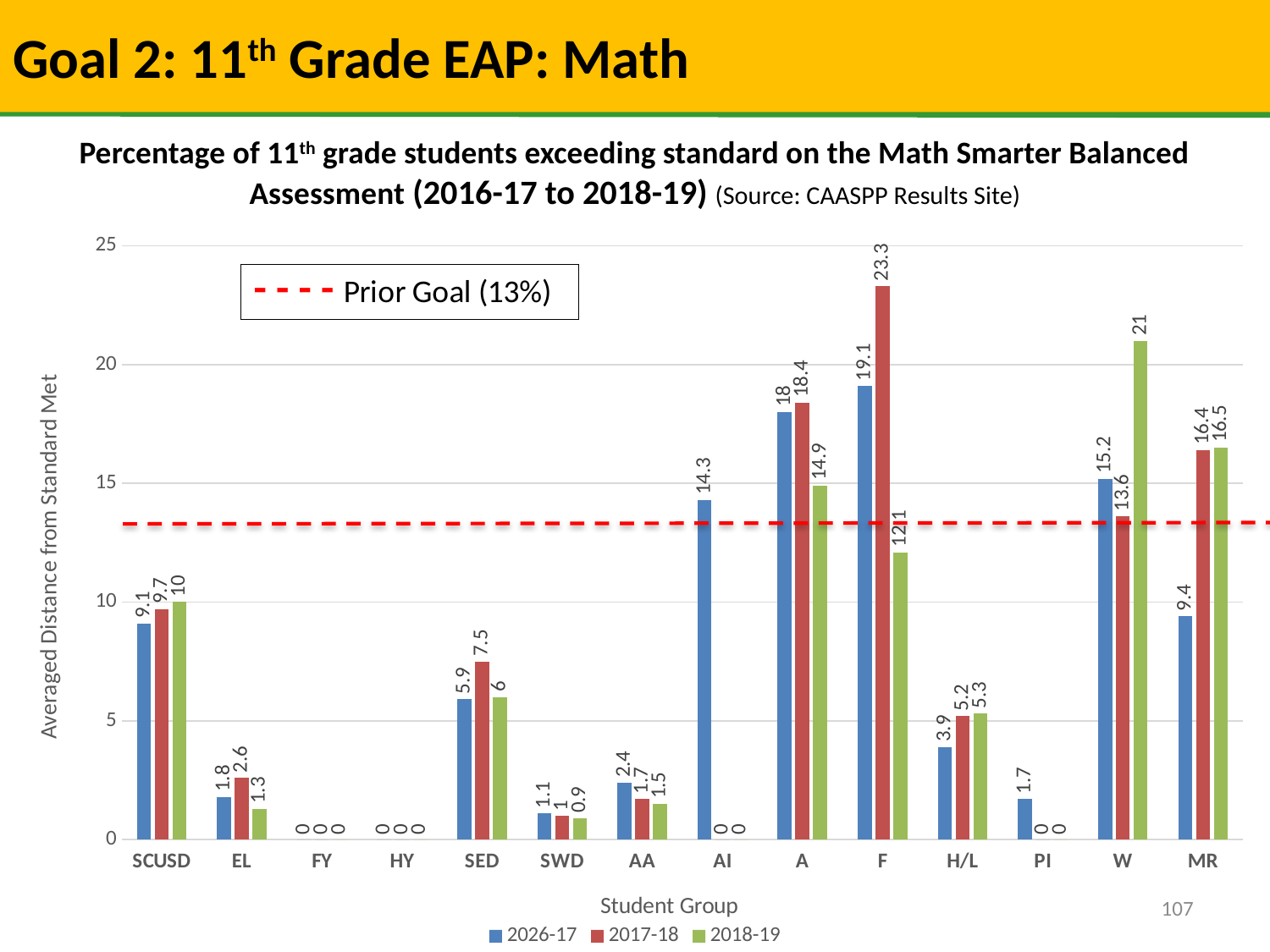
How many series does the legend list for the bars? 3 What is the 2018-19 value for the W student group? 21 How many student groups are shown on the x axis? 14 What is the 2026-17 value for the AI student group? 14.3 Which student group has the highest 2017-18 value? F Do the values for the SCUSD student group rise or fall from 2026-17 to 2018-19? rise What is the 2017-18 value for the F student group? 23.3 What value does the dashed red line labelled Prior Goal represent? 13% What type of chart is shown on the slide? bar chart Which student group has the highest 2018-19 value? W Which is larger for the SED student group, the 2017-18 value or the 2018-19 value? 2017-18 What is the difference between the 2017-18 and 2026-17 values for the MR student group? 7